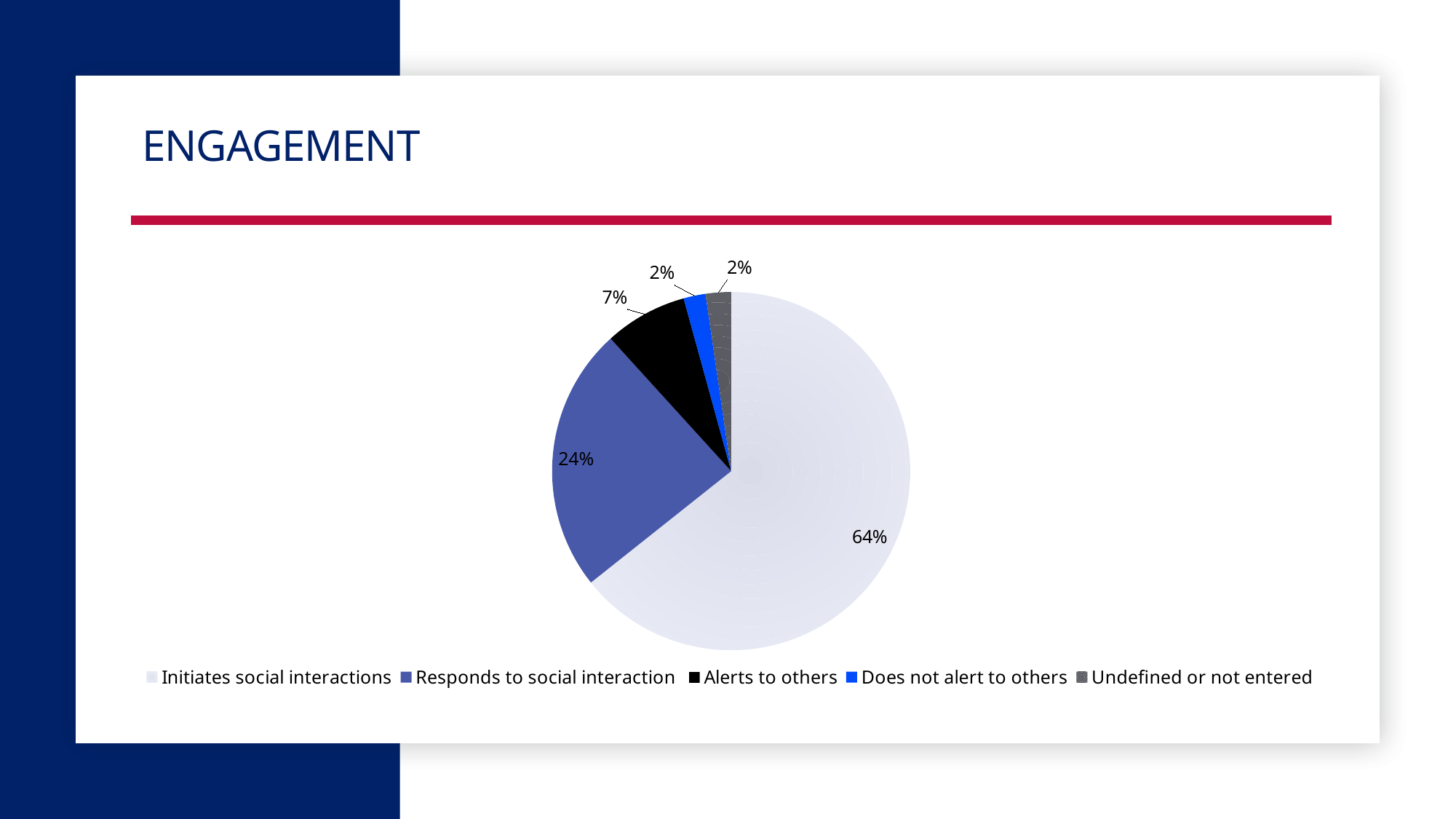
What kind of chart is shown on the slide? Pie chart What share of the pie is labelled for Initiates social interactions? 64% What share of the pie is labelled for Responds to social interaction? 24% What is the title of the slide containing the chart? ENGAGEMENT What share of the pie is labelled for Alerts to others? 7% Which legend entry is shown in black? Alerts to others Which is larger, the slice for Responds to social interaction or the slice for Alerts to others? Responds to social interaction What is the difference in percentage points between Initiates social interactions and Responds to social interaction? 40 What is the difference in percentage points between Responds to social interaction and Alerts to others? 17 Which category has the largest slice of the pie? Initiates social interactions How many categories does the legend list? 5